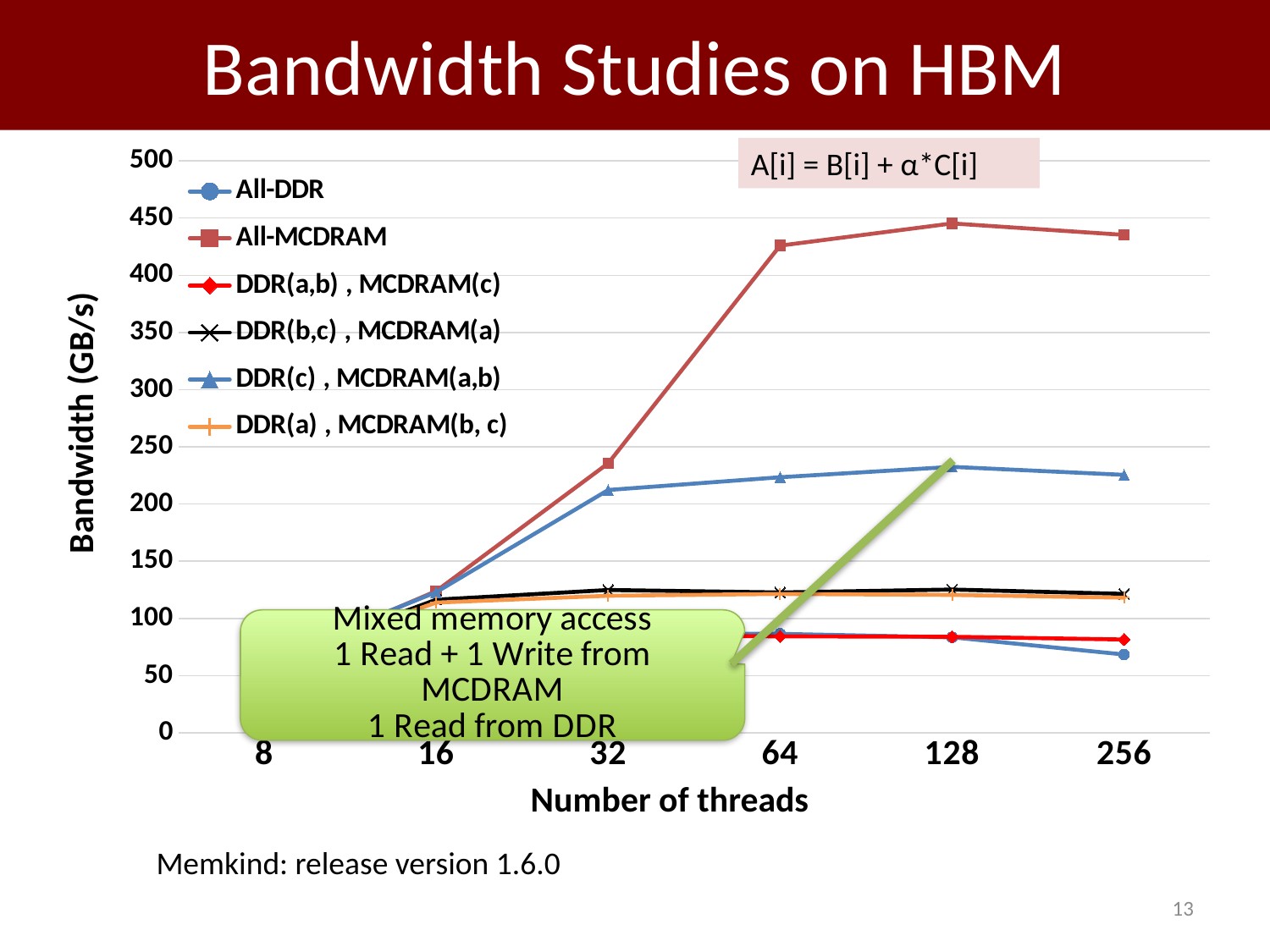
How many thread counts are plotted along the x axis? 6 How many series does the legend list? 6 At 128 threads, which series has the larger bandwidth: All-MCDRAM or DDR(c) , MCDRAM(a,b)? All-MCDRAM What kind of chart is shown on the slide? line chart Is the bandwidth for All-DDR at 256 threads greater or less than 100? less Is the bandwidth for DDR(b,c) , MCDRAM(a) at 128 threads greater or less than 150? less Is the bandwidth for All-MCDRAM at 128 threads greater or less than 400? greater Which series has the lowest bandwidth at 256 threads? All-DDR Which series has the highest bandwidth at 256 threads? All-MCDRAM What is the label of the y axis? Bandwidth (GB/s) Does the bandwidth for All-MCDRAM rise or fall from 8 threads to 128 threads? rise